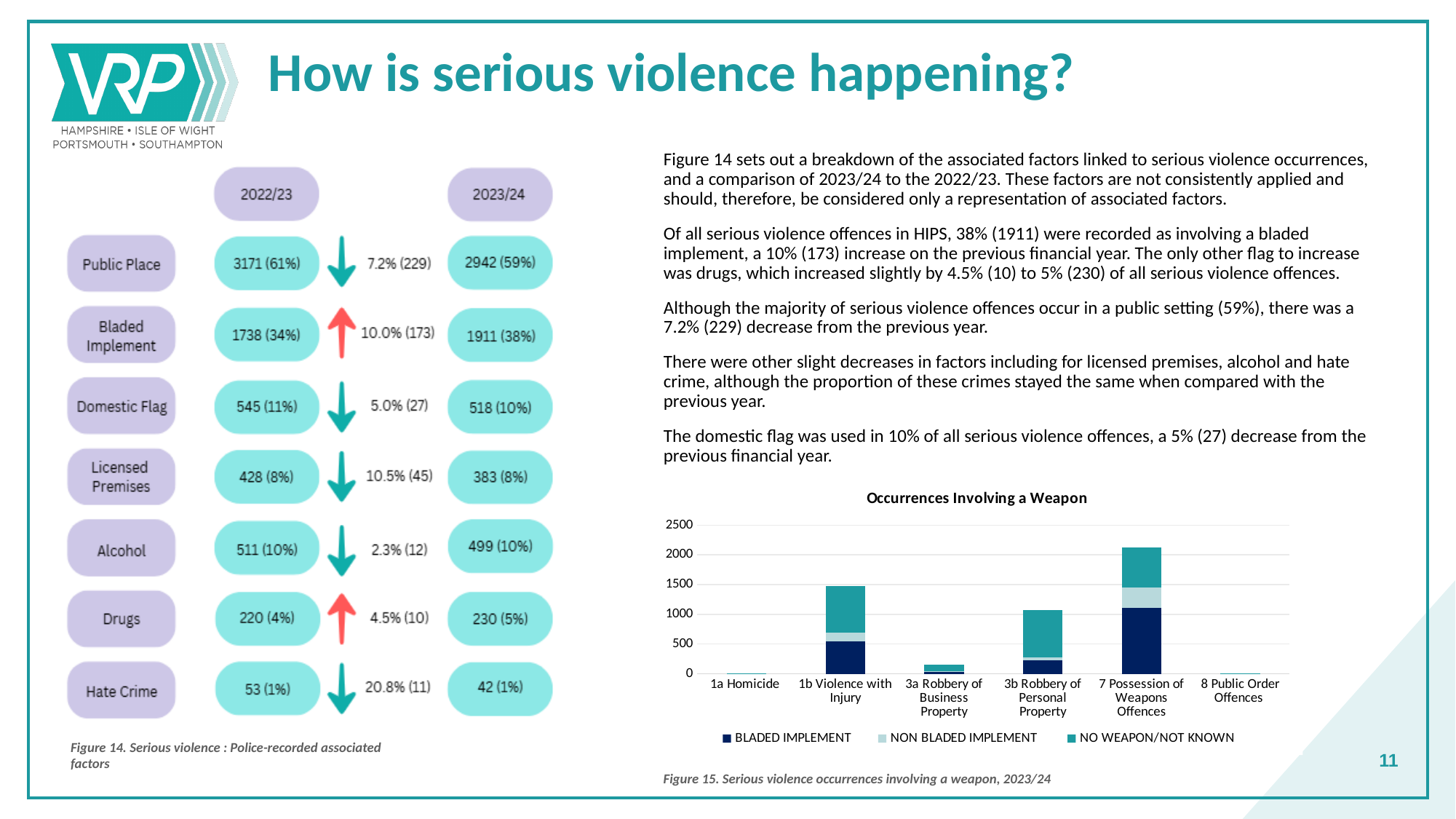
In the 'Occurrences Involving a Weapon' chart, which has the taller total bar: 1b Violence with Injury or 3b Robbery of Personal Property? 1b Violence with Injury What are the three legend entries in the 'Occurrences Involving a Weapon' chart? BLADED IMPLEMENT, NON BLADED IMPLEMENT, NO WEAPON/NOT KNOWN How many series does the legend of the 'Occurrences Involving a Weapon' chart list? 3 In the 'Occurrences Involving a Weapon' chart, is the total bar for 3b Robbery of Personal Property greater or less than 500? greater In the 'Occurrences Involving a Weapon' chart, is the total bar for 3a Robbery of Business Property greater or less than 500? less What kind of chart is 'Occurrences Involving a Weapon'? Stacked bar chart What is the title of the bar chart on the slide? Occurrences Involving a Weapon How many offence categories are shown on the x axis of the 'Occurrences Involving a Weapon' chart? 6 In the 'Occurrences Involving a Weapon' chart, which offence category has the tallest stacked bar? 7 Possession of Weapons Offences In the 'Occurrences Involving a Weapon' chart, is the BLADED IMPLEMENT segment for 7 Possession of Weapons Offences greater or less than 500? greater